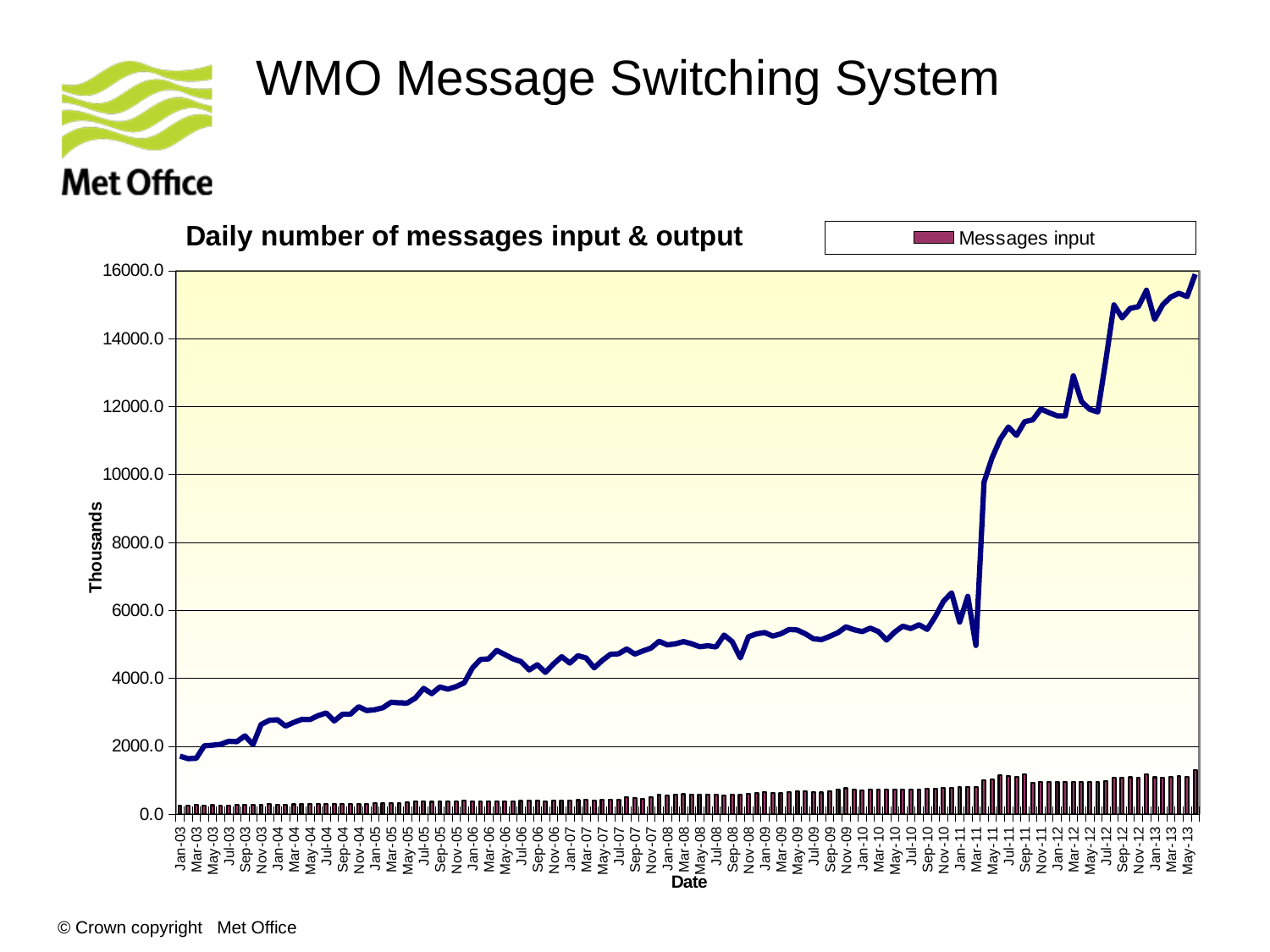
What kind of chart is shown on the slide? bar and line chart Is the value of the line at Jan-08 greater or less than 4000.0? greater What is the title of the chart? Daily number of messages input & output Does the line on the chart generally rise or fall from Jan-03 to May-13? rise How many series does the chart legend list? 1 Is the value of the line at Jan-11 greater or less than 8000.0? less Which is larger, the line value at May-13 or the line value at Jan-03? May-13 Is the Messages input bar at May-13 greater or less than 2000.0? less What is the label on the vertical axis of the chart? Thousands